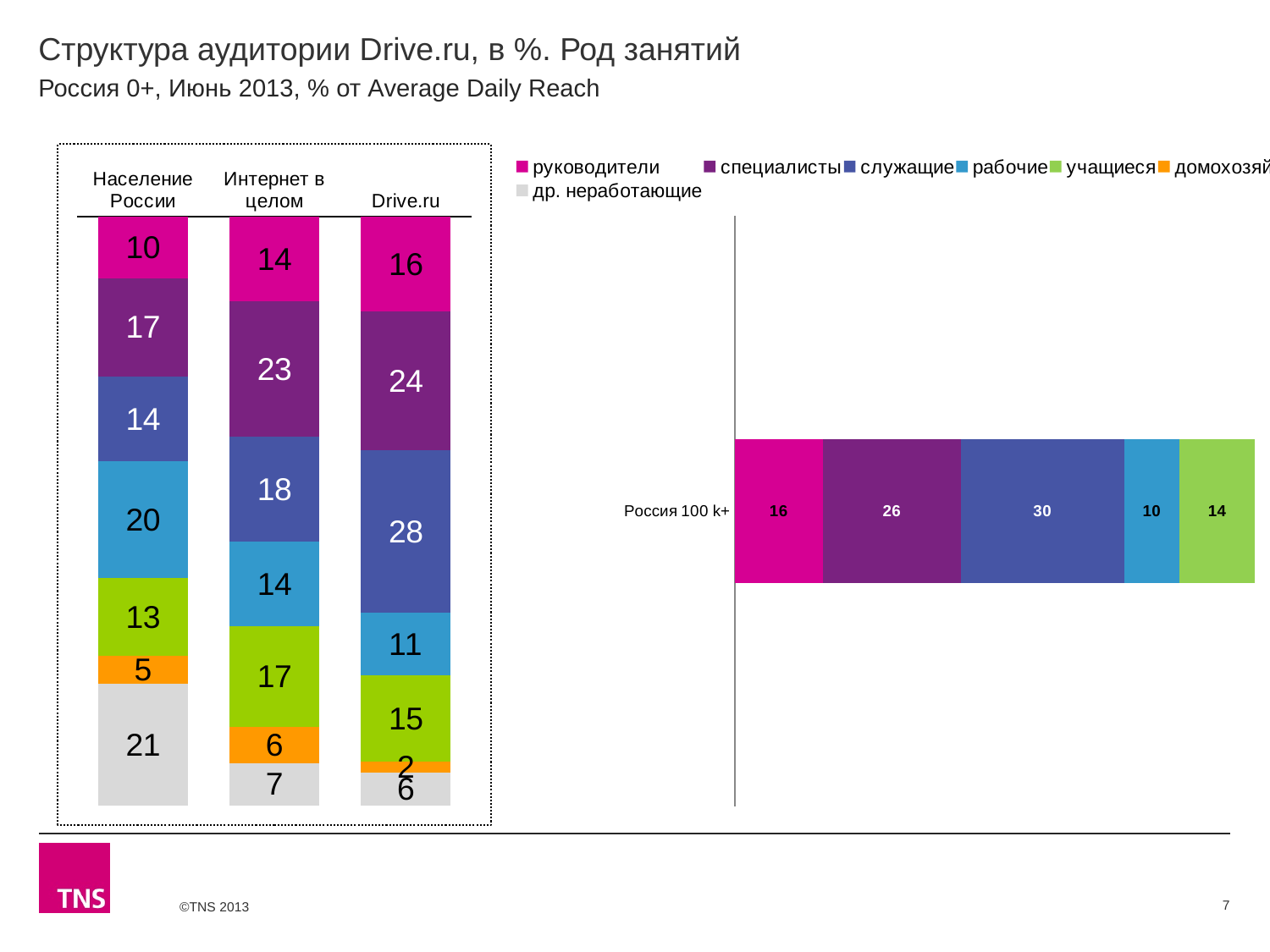
On the right chart, what is the value for служащие in the Россия 100 k+ bar? 30 How many series does the legend list? 7 How many bars (categories) does the left chart show? 3 On the left chart, what is the difference between the руководители values for Drive.ru and Население России? 6 On the left chart, what is the value for специалисты in the Drive.ru bar? 24 On the left chart, what is the value for служащие in the Интернет в целом bar? 18 On the left chart, which of the three bars has the smallest др. неработающие segment? Drive.ru What type of chart is the right chart? Stacked bar chart On the left chart, what is the value for рабочие in the Население России bar? 20 On the left chart, is the рабочие value larger for Население России or for Drive.ru? Население России On the left chart, which of the three bars has the largest служащие segment? Drive.ru On the right chart, what is the total of the labelled segments in the Россия 100 k+ bar? 96